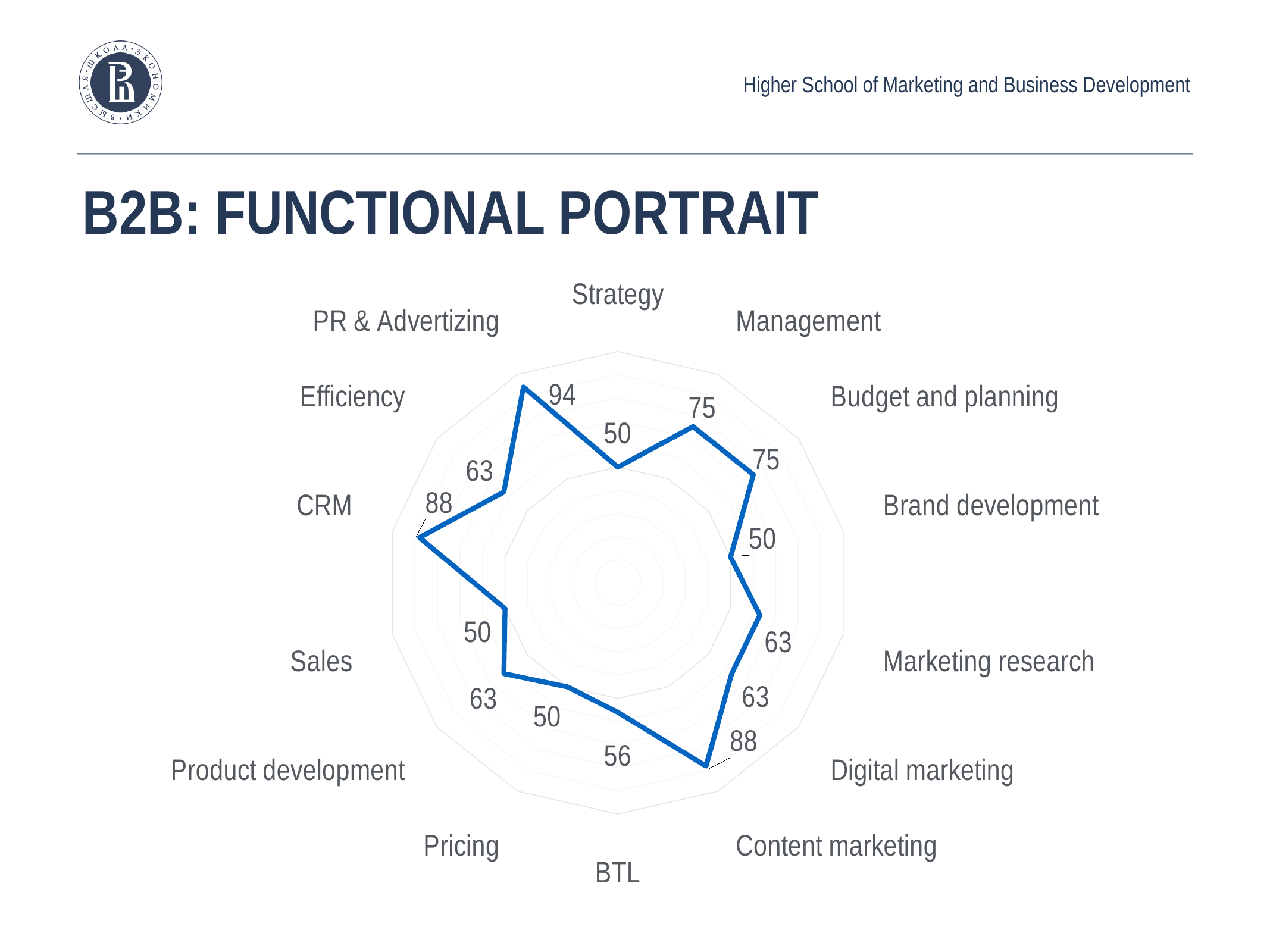
What is the value for CRM? 88 What is the difference between the values for PR & Advertizing and Strategy? 44 What is the value for PR & Advertizing? 94 How many categories are plotted on the radar chart? 14 What is the value for Strategy? 50 What is the value for Content marketing? 88 Which is larger, the value for Content marketing or the value for BTL? Content marketing What is the value for BTL? 56 What is the value for Management? 75 What is the lowest value shown on the chart? 50 What kind of chart is shown on the slide? radar chart Which category has the highest value? PR & Advertizing